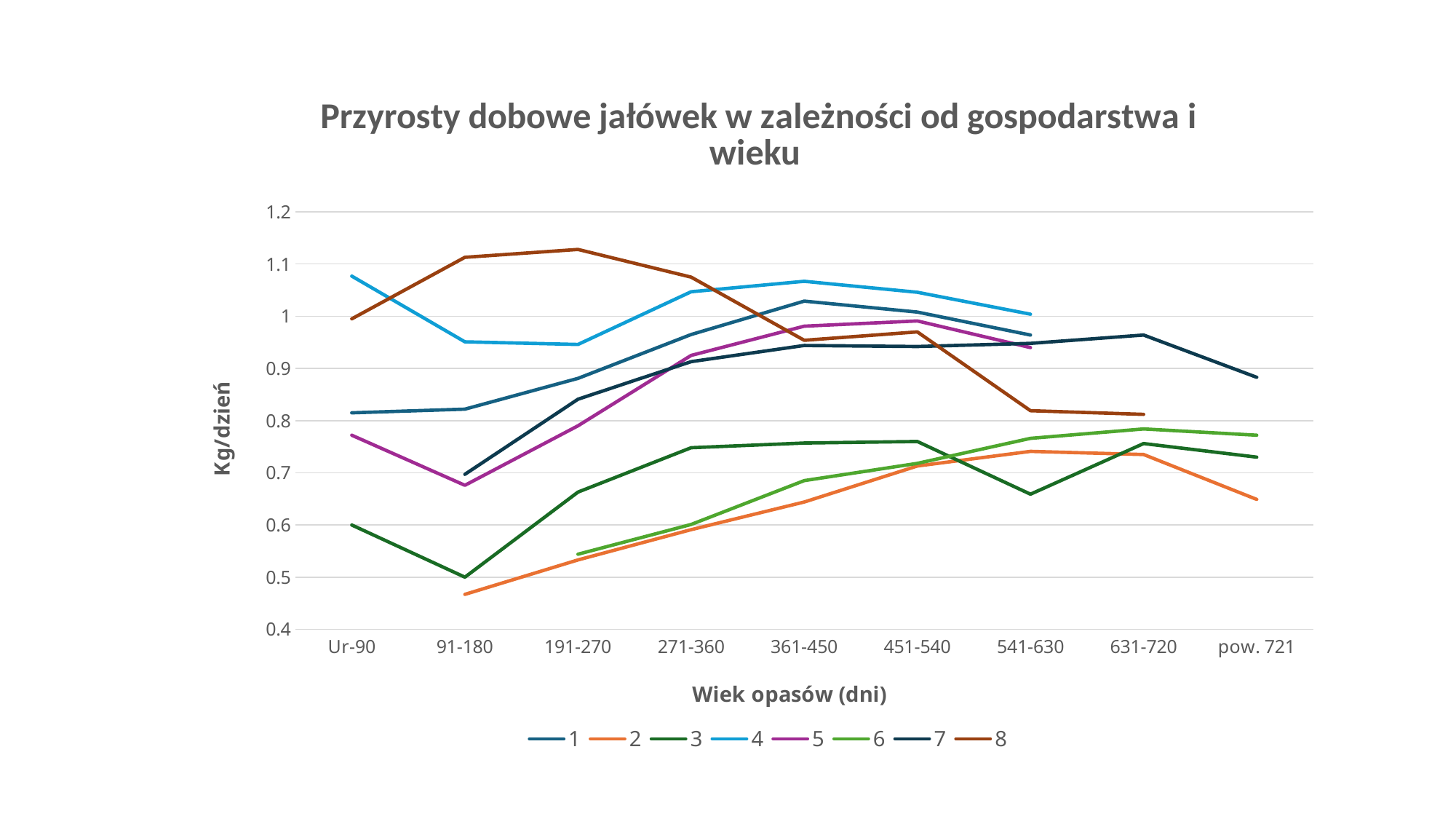
What kind of chart is shown on the slide? line chart Which series has the highest value at 631-720? 7 Which series has the highest value at 191-270? 8 Is the value for series 2 at 91-180 greater or less than 0.5? less Is the value for series 8 at 191-270 greater or less than 1.1? greater How many age categories are shown on the x axis? 9 Is the value for series 3 at 541-630 greater or less than 0.7? less What is the title of the chart? Przyrosty dobowe jałówek w zależności od gospodarstwa i wieku At Ur-90, which series has the higher value, series 4 or series 1? 4 What is the label of the vertical axis? Kg/dzień How many series does the legend list? 8 Does the value for series 8 rise or fall from 191-270 to 541-630? fall